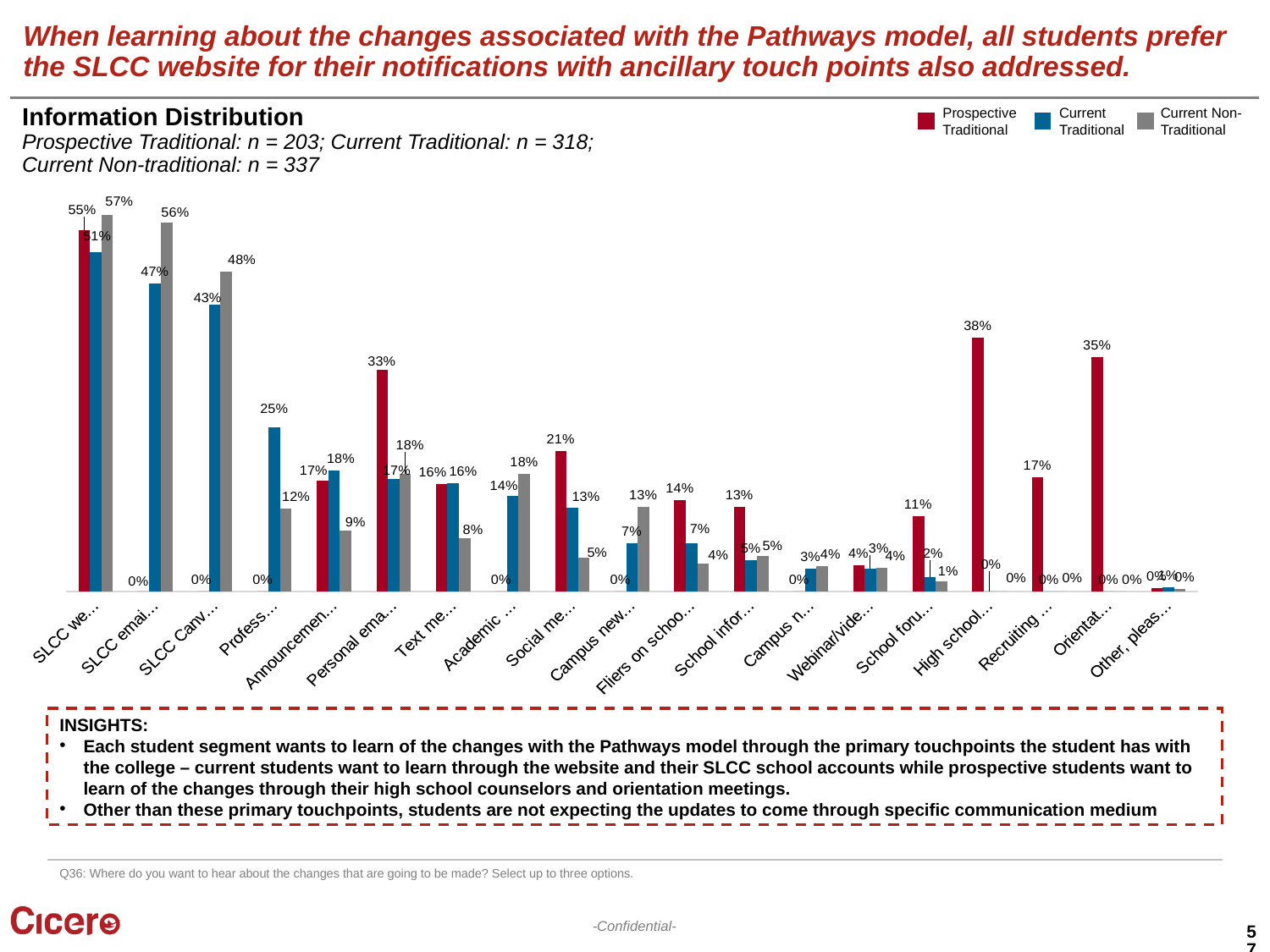
For Prospective Traditional, what is the difference between the 'High school…' value and the 'Orientat…' value? 3 percentage points What type of chart is shown on the slide? Bar chart What is the sample size (n) given for Current Non-traditional in the chart subtitle? 337 What is the Prospective Traditional value for the category labelled 'Social me…'? 21% For the category labelled 'SLCC emai…', which is larger: the Current Traditional value or the Current Non-Traditional value? Current Non-Traditional What is the Current Traditional value for the category labelled 'Profess…'? 25% How many categories are plotted along the x axis of the Information Distribution chart? 19 What is the Prospective Traditional value for the category labelled 'High school…'? 38% Which series has the highest value for the category labelled 'Personal ema…'? Prospective Traditional Which category has the highest Prospective Traditional value? SLCC we… What is the Current Non-Traditional value for the first category, 'SLCC we…'? 57% How many series does the legend of the Information Distribution chart list? 3